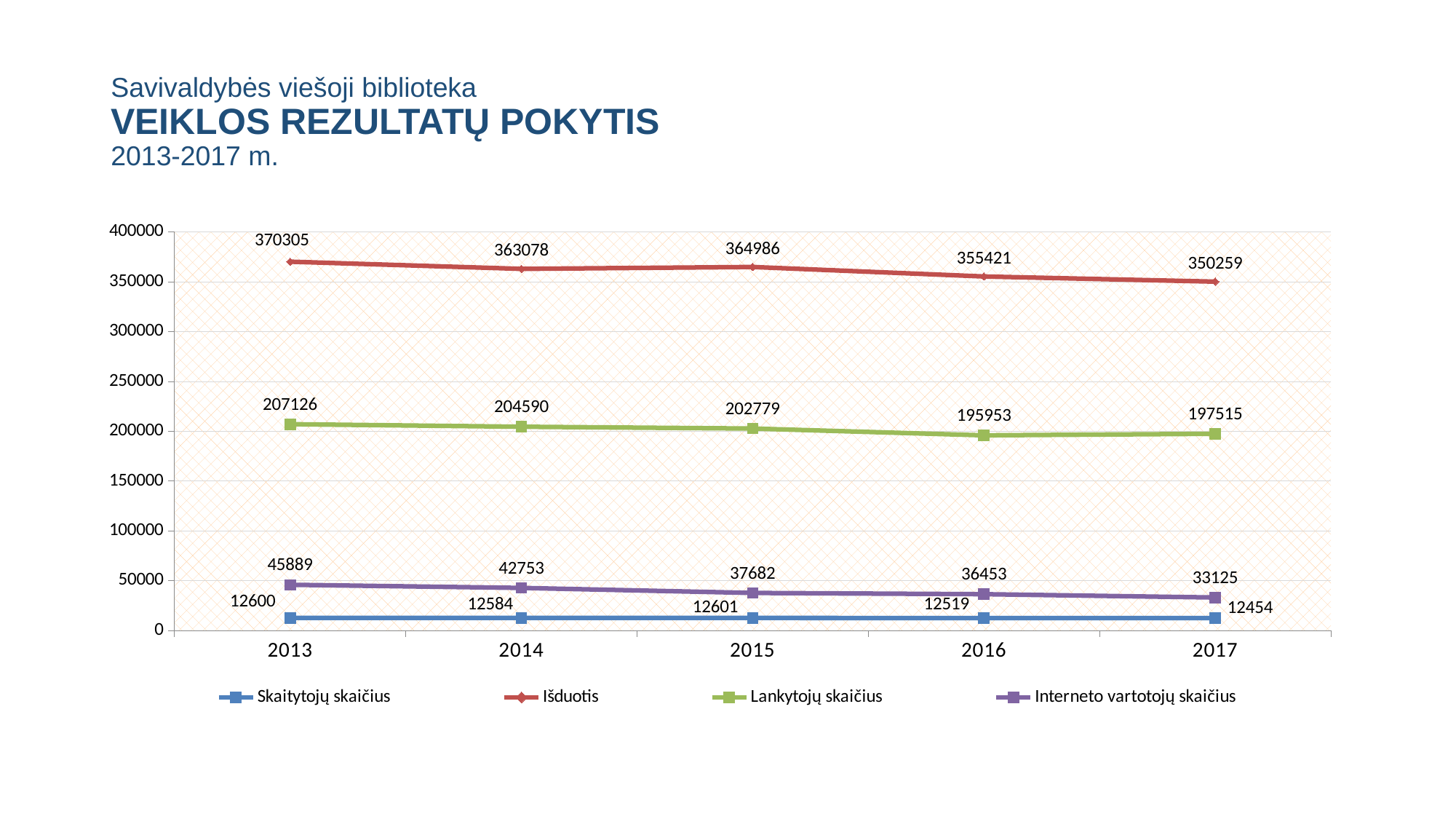
What is the value of Lankytojų skaičius in 2016? 195953 In which year is Interneto vartotojų skaičius lowest? 2017 What kind of chart is shown on the slide? line chart What is the value of Skaitytojų skaičius in 2015? 12601 What is the value of Išduotis in 2013? 370305 Which is larger: Lankytojų skaičius in 2016 or in 2017? 2017 How many series does the legend list? 4 What is the value of Interneto vartotojų skaičius in 2017? 33125 How many years are shown on the x axis? 5 What is the difference between Išduotis in 2013 and in 2017? 20046 Is the value of Išduotis in 2017 greater or less than 300000? greater In which year is Išduotis highest? 2013